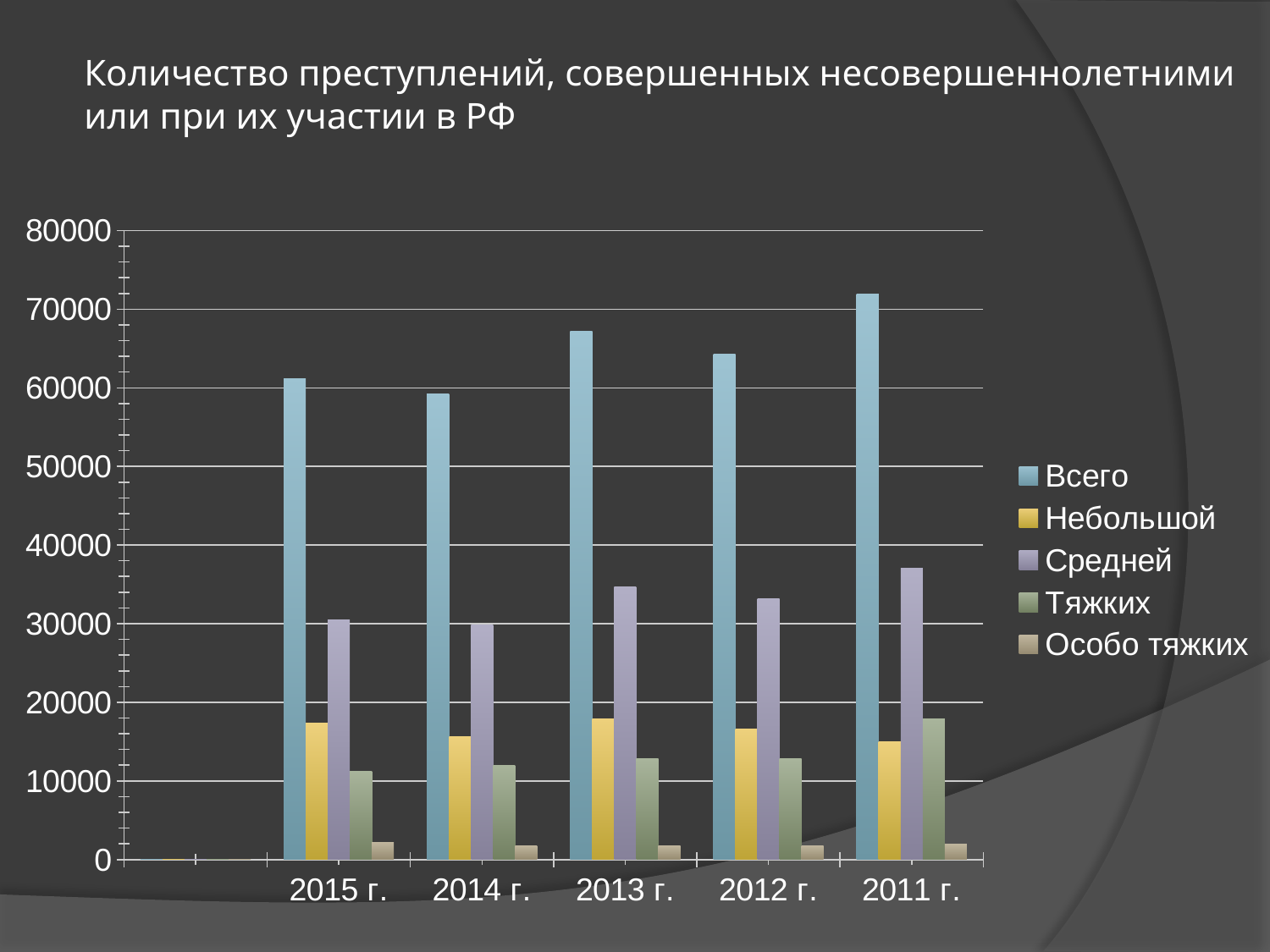
Is the value for Средней in 2013 г. greater or less than 30000? greater Which is larger, the value for Всего in 2013 г. or in 2012 г.? 2013 г. In which year is the value for Средней the highest? 2011 г. How many series does the legend list? 5 How many year categories are shown on the x axis? 5 Is the value for Особо тяжких in 2015 г. greater or less than 10000? less What is the title of the chart? Количество преступлений, совершенных несовершеннолетними или при их участии в РФ What kind of chart is shown on the slide? bar chart In which year is the value for Тяжких the highest? 2011 г. In which year is the value for Всего the highest? 2011 г. Is the value for Всего in 2011 г. greater or less than 70000? greater